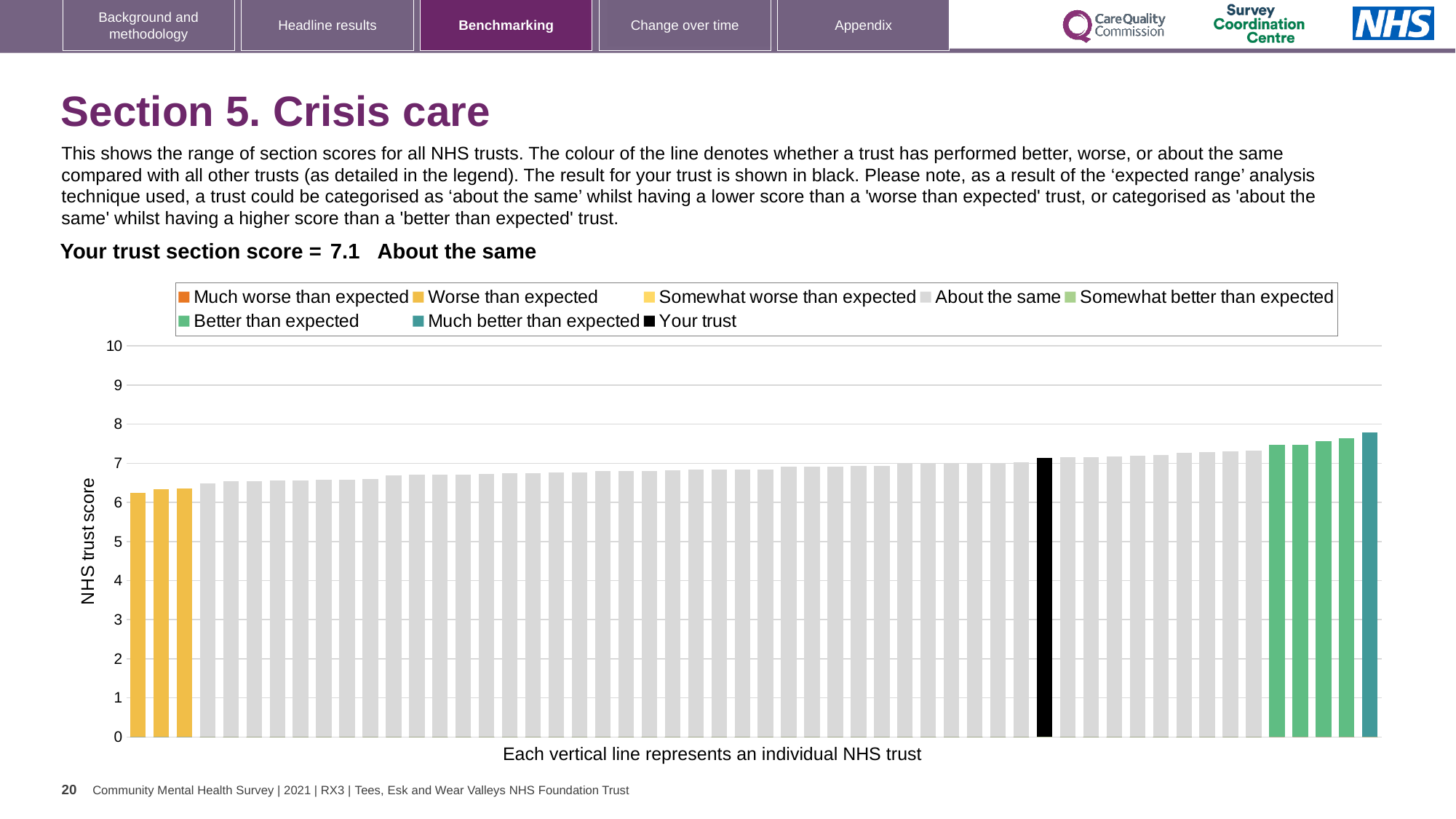
Which is higher, the black bar for your trust or the leftmost bar? The black bar for your trust What is the section score for your trust shown on the slide? 7.1 Is the value for the rightmost bar greater or less than 8? less Which performance category is your trust placed in for crisis care? About the same What kind of chart is shown on the slide? Bar chart What is the label on the vertical axis of the chart? NHS trust score Is the value for the leftmost bar greater or less than 7? less How many entries does the chart legend list? 8 What colour is used to show your trust in the chart? Black Do the bar values rise or fall from left to right along the x axis? Rise How many bars are coloured as 'Worse than expected' (yellow)? 3 Is the value for the leftmost bar greater or less than 6? greater